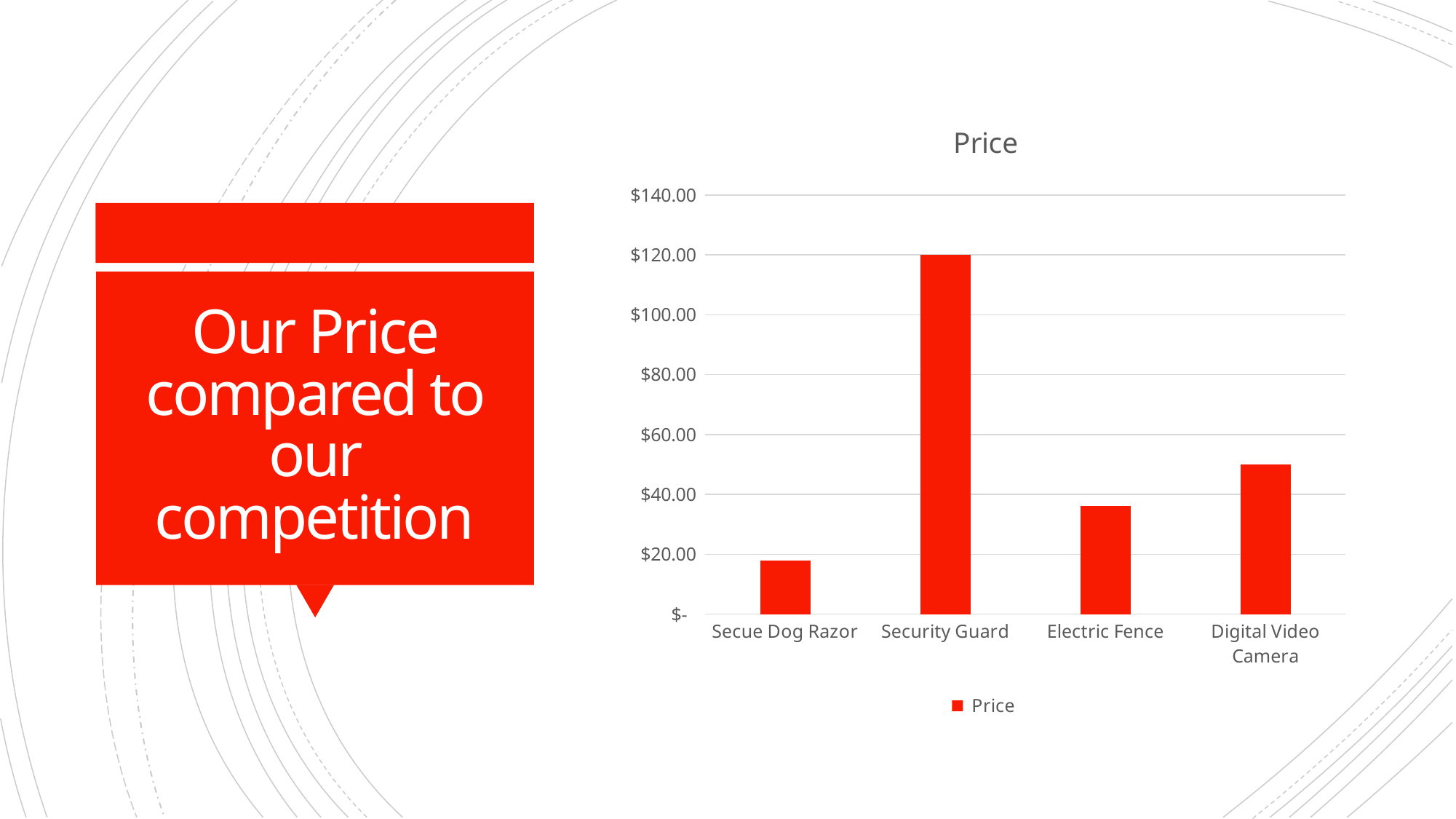
Which category has the lowest price? Secue Dog Razor What is the title of the chart? Price Which category has the highest price? Security Guard What type of chart is shown on the slide? Bar chart What is the price shown for Security Guard? $120.00 What colour are the bars in the chart? Red Which has a higher price, Digital Video Camera or Electric Fence? Digital Video Camera How many categories are shown on the x axis of the chart? 4 Is the value for Secue Dog Razor greater or less than $40.00? less How many series does the chart's legend list? 1 Is the value for Digital Video Camera greater or less than $40.00? greater Is the value for Electric Fence greater or less than $60.00? less